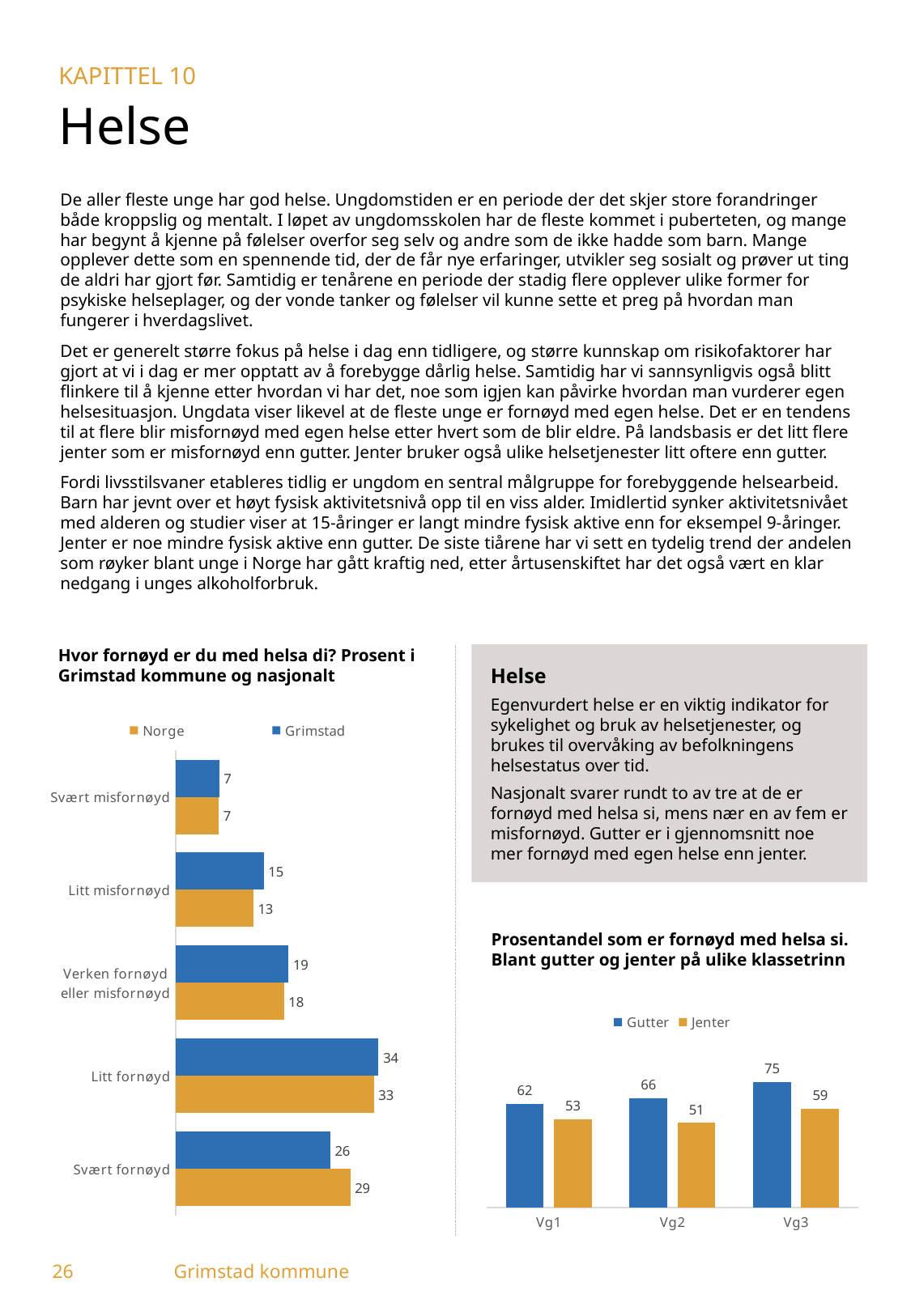
In the chart 'Hvor fornøyd er du med helsa di?', which category has the lowest value for Norge? Svært misfornøyd In the chart 'Prosentandel som er fornøyd med helsa si', which class level has the highest value for Gutter? Vg3 In the chart 'Prosentandel som er fornøyd med helsa si', what is the difference between Gutter and Jenter at Vg3? 16 In the chart 'Hvor fornøyd er du med helsa di?', how many categories are shown on the axis? 5 In the chart 'Hvor fornøyd er du med helsa di?', what is the value for Norge in the 'Svært fornøyd' category? 29 In the chart 'Hvor fornøyd er du med helsa di?', how many series does the legend list? 2 What kind of chart is 'Hvor fornøyd er du med helsa di?'? Bar chart In the chart 'Hvor fornøyd er du med helsa di?', which category has the highest value for Grimstad? Litt fornøyd In the chart 'Prosentandel som er fornøyd med helsa si', what is the value for Jenter at Vg2? 51 In the chart 'Hvor fornøyd er du med helsa di?', what is the value for Grimstad in the 'Litt fornøyd' category? 34 In the chart 'Prosentandel som er fornøyd med helsa si', do the values for Gutter rise or fall from Vg1 to Vg3? Rise In the chart 'Hvor fornøyd er du med helsa di?', what is the difference between the Norge and Grimstad values for 'Svært fornøyd'? 3